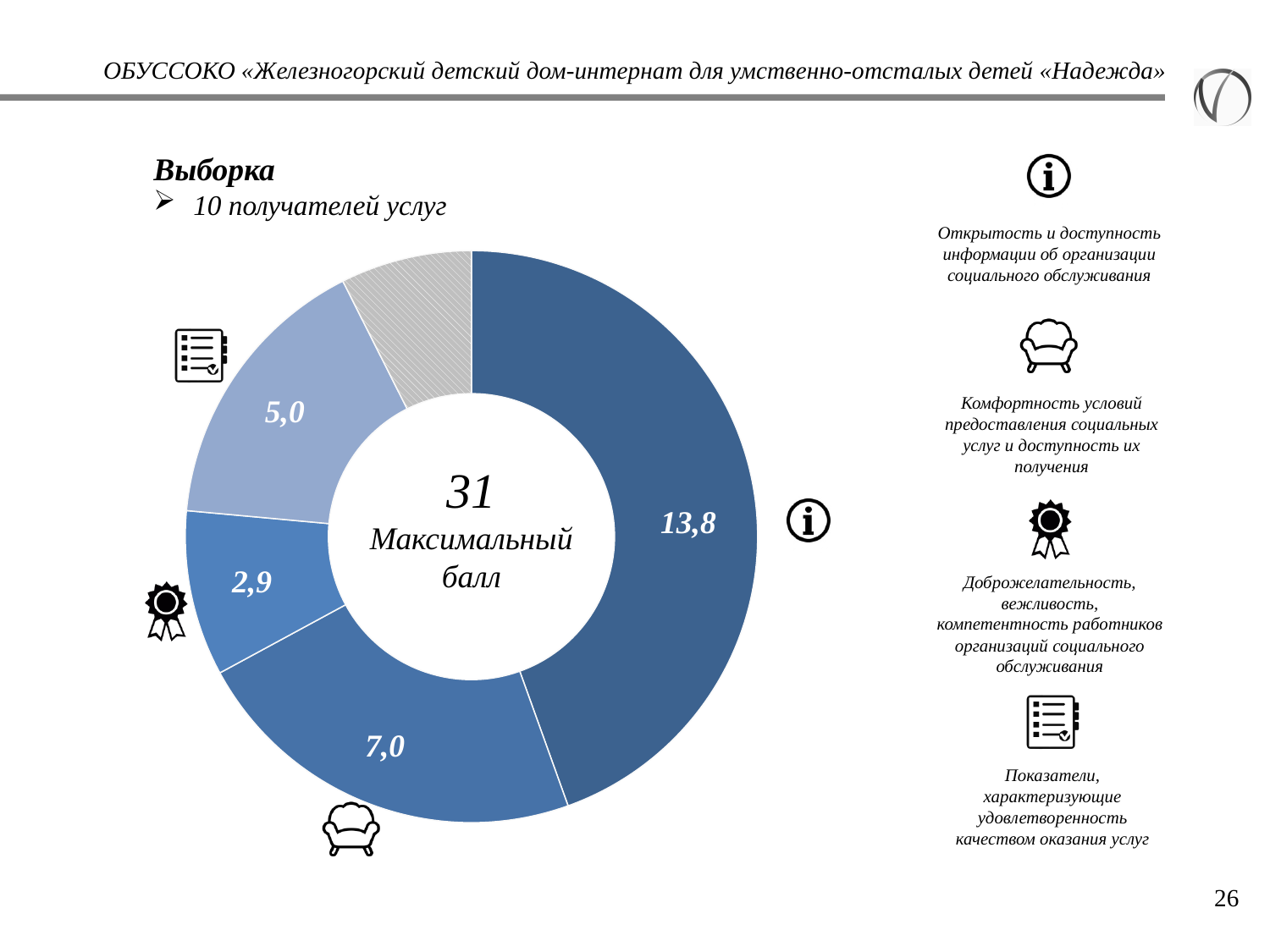
What value is shown for the segment marked with the armchair icon (Комфортность условий предоставления социальных услуг и доступность их получения)? 7,0 Among the segments with printed values, which criterion has the lowest value? Доброжелательность, вежливость, компетентность работников организаций социального обслуживания (2,9) Which criterion has the highest value in the doughnut chart? Открытость и доступность информации об организации социального обслуживания (13,8) What value is shown for the segment marked with the information icon (Открытость и доступность информации об организации социального обслуживания)? 13,8 What value is shown for the segment marked with the checklist icon (Показатели, характеризующие удовлетворенность качеством оказания услуг)? 5,0 What is the difference between the largest segment value (13,8) and the comfort-of-conditions segment value (7,0)? 6,8 What type of chart is shown on the slide? Doughnut chart What is the difference between the comfort-of-conditions segment (7,0) and the satisfaction-indicators segment (5,0)? 2,0 What value is shown for the segment marked with the medal icon (Доброжелательность, вежливость, компетентность работников организаций социального обслуживания)? 2,9 How many segments in the doughnut chart have a printed value label? 4 Which is larger: the satisfaction-indicators segment or the goodwill/competence-of-staff segment? Satisfaction-indicators segment (5,0) What maximum score is shown in the centre of the doughnut chart? 31